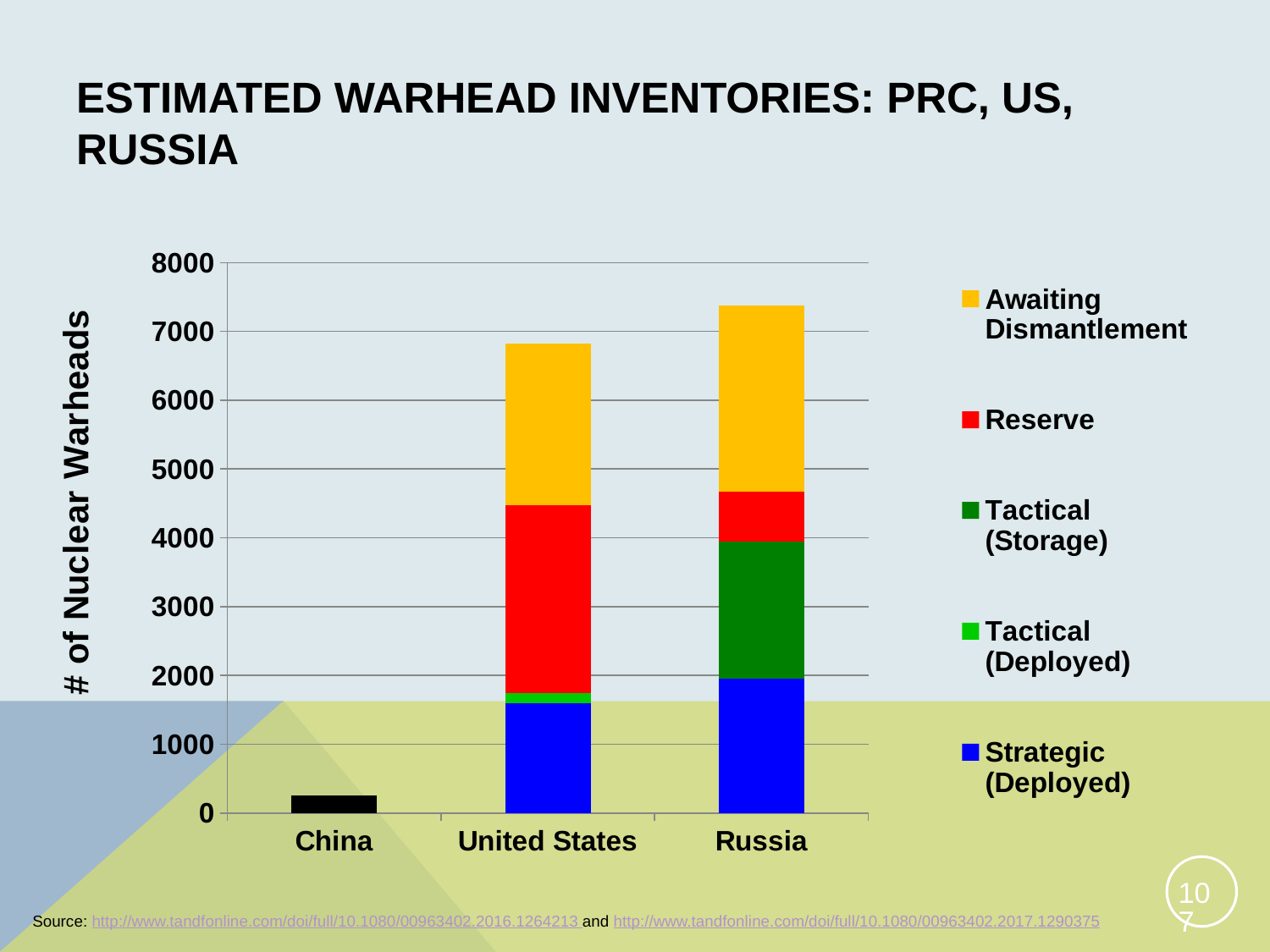
Is the Strategic (Deployed) segment for the United States greater or less than 2000? less Which country has the highest total number of nuclear warheads in the chart? Russia Is the total bar for China greater or less than 1000? less What kind of chart is shown on the slide? stacked bar chart Which legend entry is shown in yellow? Awaiting Dismantlement Is the total bar for the United States greater or less than 7000? less How many countries are shown on the x axis of the chart? 3 What is the label on the vertical axis of the chart? # of Nuclear Warheads Which country has the lowest total number of nuclear warheads in the chart? China Which country has the larger total bar, the United States or China? United States How many series does the chart legend list? 5